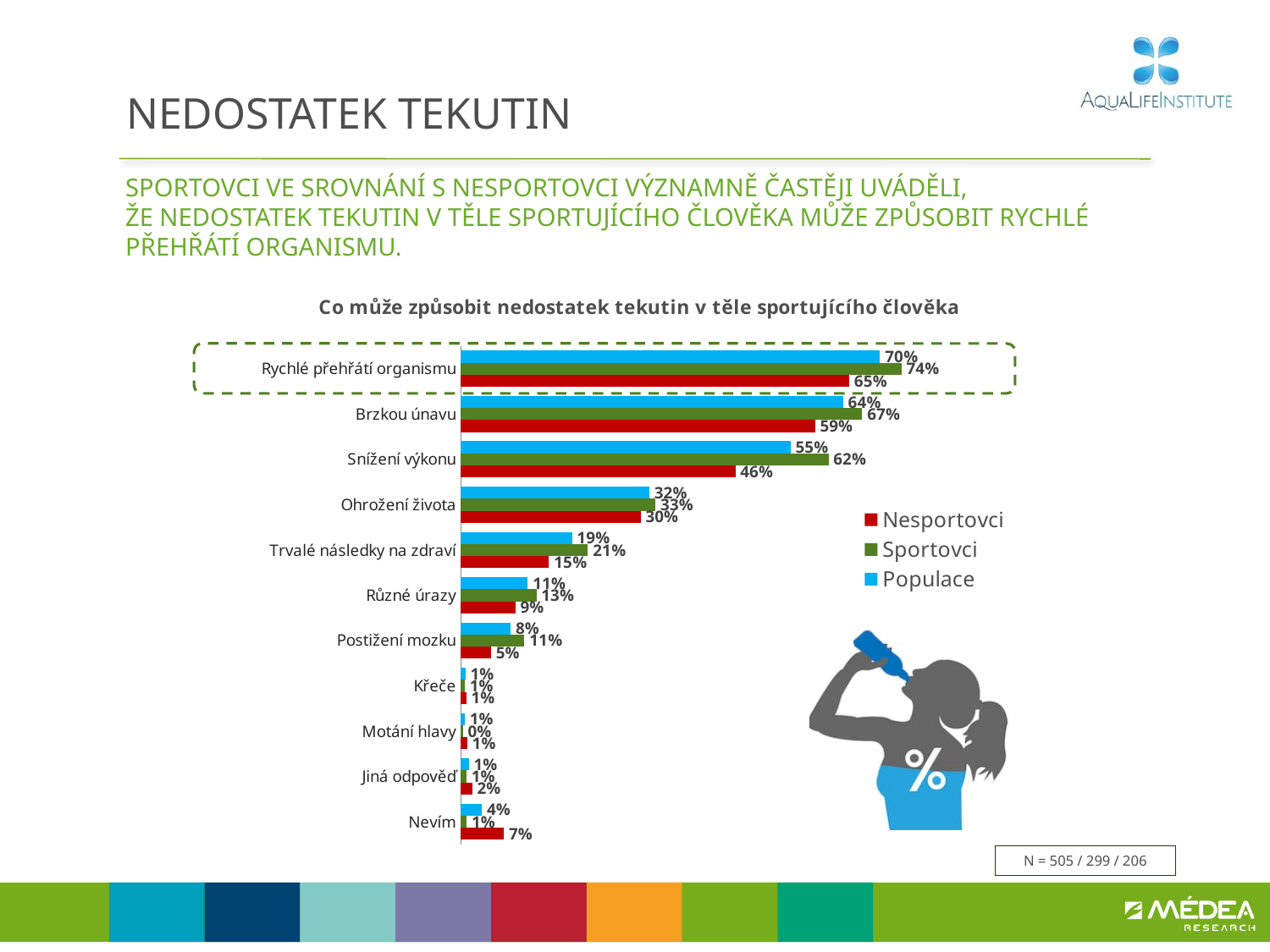
What is the difference between the Sportovci and Nesportovci values for 'Snížení výkonu'? 16% Which is larger for 'Nevím': the Nesportovci value or the Sportovci value? Nesportovci How many series does the legend list? 3 How many categories are shown on the chart? 11 What is the title of the chart? Co může způsobit nedostatek tekutin v těle sportujícího člověka What is the difference between the Populace and Nesportovci values for 'Rychlé přehřátí organismu'? 5% What is the value for Populace for 'Brzkou únavu'? 64% Which category has the highest value for Sportovci? Rychlé přehřátí organismu What is the value for Nesportovci for 'Snížení výkonu'? 46% What is the value for Sportovci for 'Rychlé přehřátí organismu'? 74% What is the value for Nesportovci for 'Postižení mozku'? 5% What kind of chart is shown on the slide? bar chart